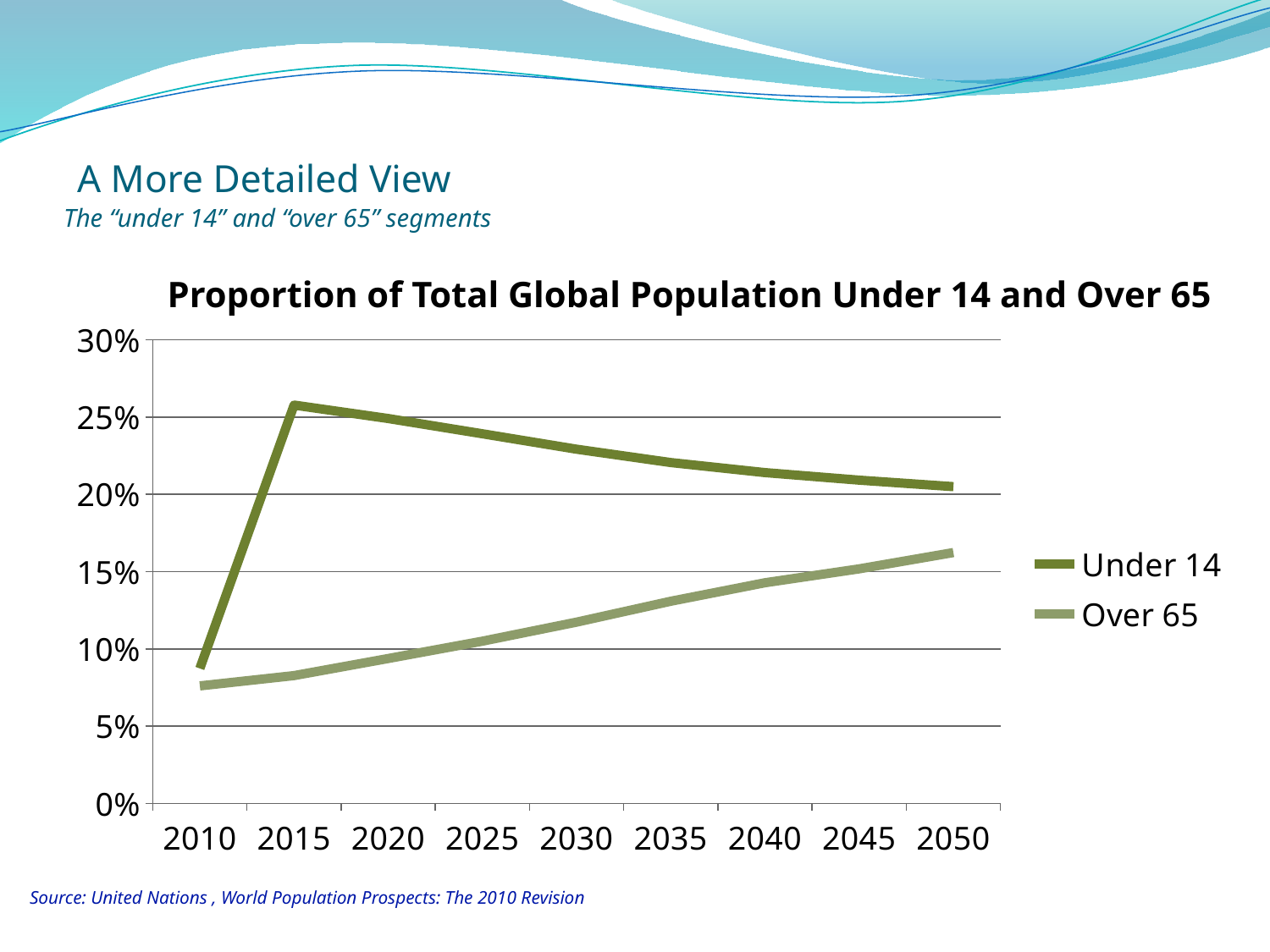
In which year does the Under 14 line reach its highest value? 2015 How many years are marked along the x axis? 9 In which year does the Over 65 line reach its highest value? 2050 In 2050, which series has the larger value, Under 14 or Over 65? Under 14 How many series does the legend list? 2 Is the value for Over 65 in 2010 greater or less than 10%? less Is the value for Under 14 in 2015 greater or less than 20%? greater What is the title of the chart? Proportion of Total Global Population Under 14 and Over 65 In which year is the Under 14 line at its lowest value? 2010 Is the value for Over 65 in 2050 greater or less than 15%? greater Does the Over 65 line rise or fall from 2010 to 2050? rise What kind of chart is shown on the slide? line chart